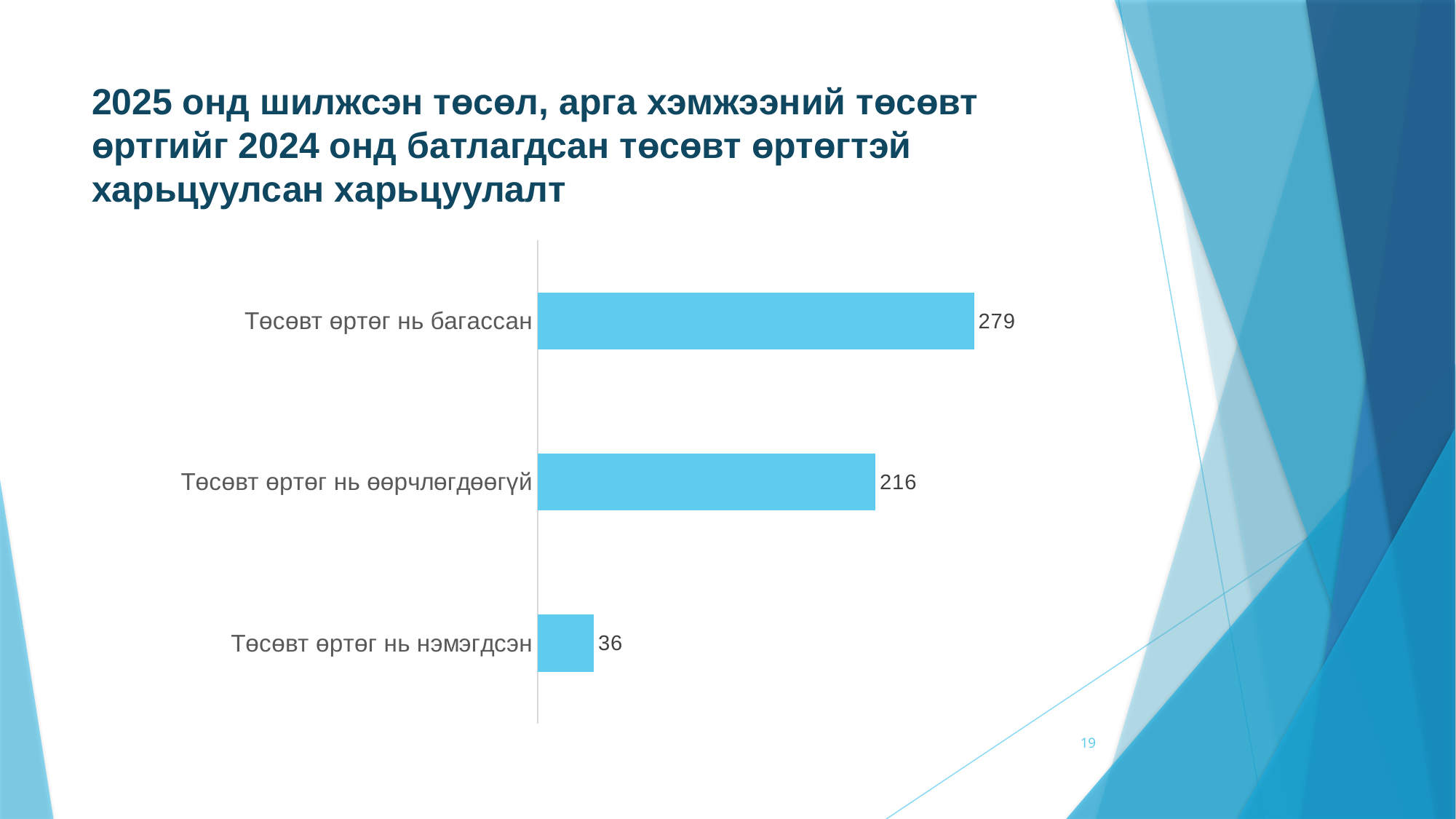
Which category has the lowest value? Төсөвт өртөг нь нэмэгдсэн Which category has the highest value? Төсөвт өртөг нь багассан What is the difference between the values for "Төсөвт өртөг нь багассан" and "Төсөвт өртөг нь өөрчлөгдөөгүй"? 63 What colour are the bars in the chart? Light blue What is the difference between the values for "Төсөвт өртөг нь өөрчлөгдөөгүй" and "Төсөвт өртөг нь нэмэгдсэн"? 180 What is the value for "Төсөвт өртөг нь өөрчлөгдөөгүй"? 216 What kind of chart is shown on the slide? Bar chart What is the value for "Төсөвт өртөг нь багассан"? 279 What is the total of all three values shown in the chart? 531 What is the value for "Төсөвт өртөг нь нэмэгдсэн"? 36 How many categories are shown in the chart? 3 Which is larger: the value for "Төсөвт өртөг нь өөрчлөгдөөгүй" or the value for "Төсөвт өртөг нь нэмэгдсэн"? Төсөвт өртөг нь өөрчлөгдөөгүй